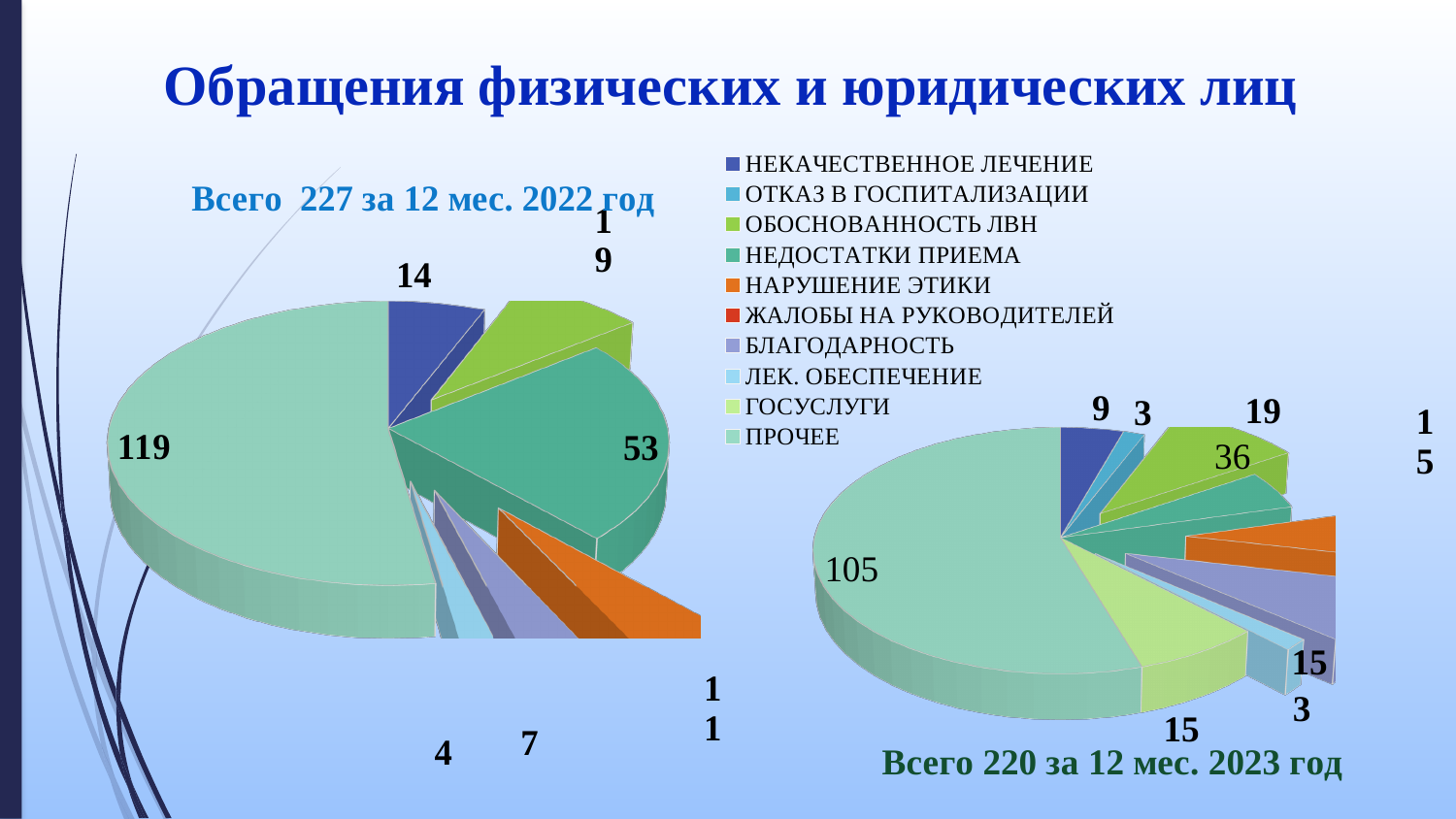
In the 2022 chart (left), what is the value for НЕДОСТАТКИ ПРИЕМА? 53 In the chart titled 'Всего 220 за 12 мес. 2023 год', what is the value for ПРОЧЕЕ? 105 What is the total number of appeals shown for the 2023 chart (right)? 220 What kind of charts are shown on the slide? Pie charts What is the title of the slide? Обращения физических и юридических лиц How many entries does the legend list? 10 In the 2022 chart (left), what is the difference between ПРОЧЕЕ and НЕДОСТАТКИ ПРИЕМА? 66 In the 2023 chart (right), what is the value for НЕДОСТАТКИ ПРИЕМА? 36 In the 2022 chart (left), which category has the largest slice? ПРОЧЕЕ Is the value for НЕКАЧЕСТВЕННОЕ ЛЕЧЕНИЕ larger in the 2022 chart (left) or the 2023 chart (right)? 2022 chart (left) In the 2023 chart (right), what is the value for ОБОСНОВАННОСТЬ ЛВН? 19 In the chart titled 'Всего 227 за 12 мес. 2022 год', what is the value for ПРОЧЕЕ? 119